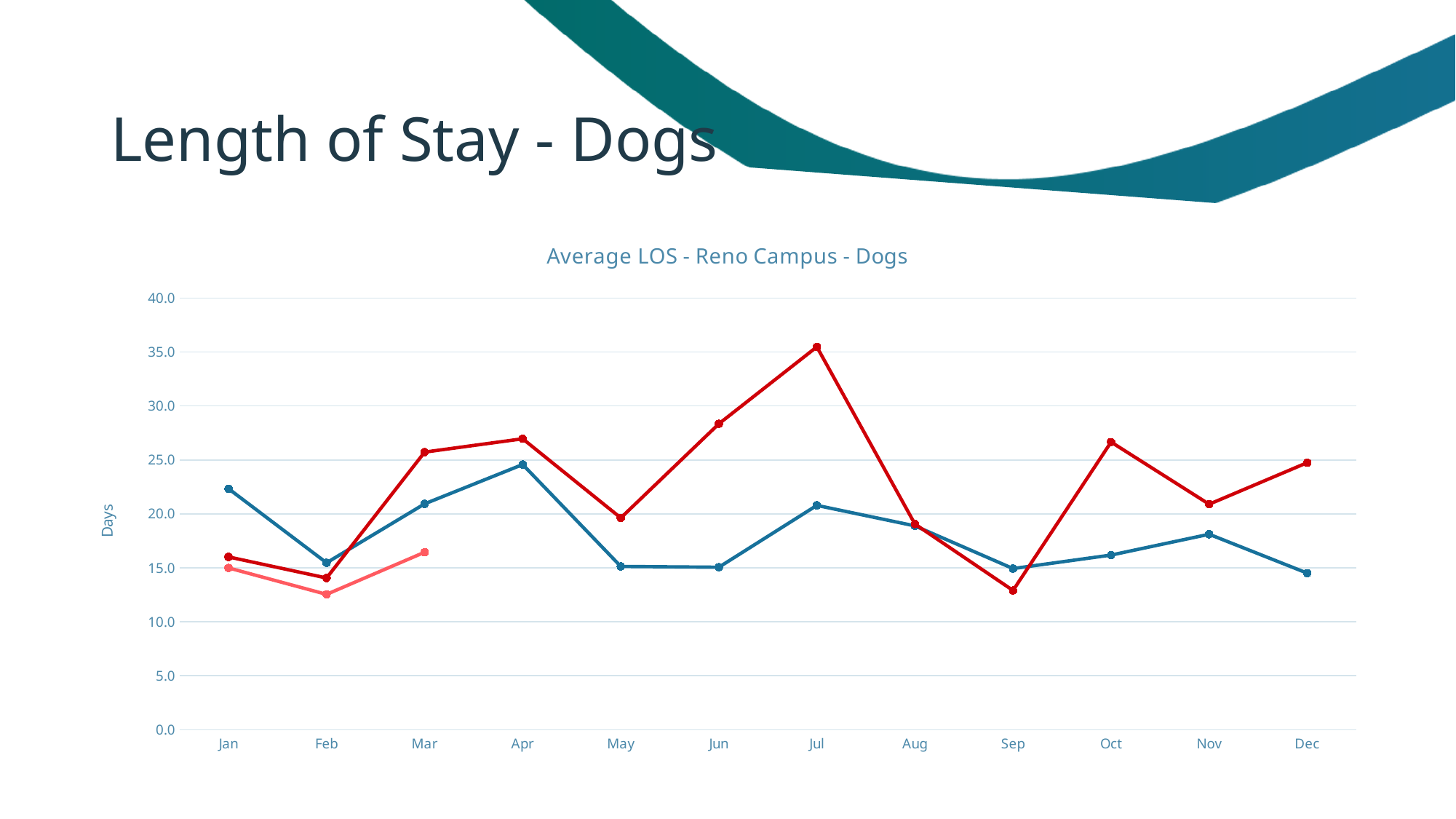
How many months are shown along the x axis of the chart? 12 What kind of chart is shown on the slide? Line chart What is the label on the vertical axis of the chart? Days In which month does the red line reach its highest value? Jul Is the value of the red line in Jul greater or less than 30.0? greater Does the red line rise or fall from Jun to Jul? Rise In which month does the red line reach its lowest value? Sep What is the title of the chart? Average LOS - Reno Campus - Dogs In Jan, which line has the higher value, the blue line or the red line? The blue line Is the value of the red line in Sep greater or less than 15.0? less How many lines are plotted on the chart? 3 In which month does the blue line reach its highest value? Apr